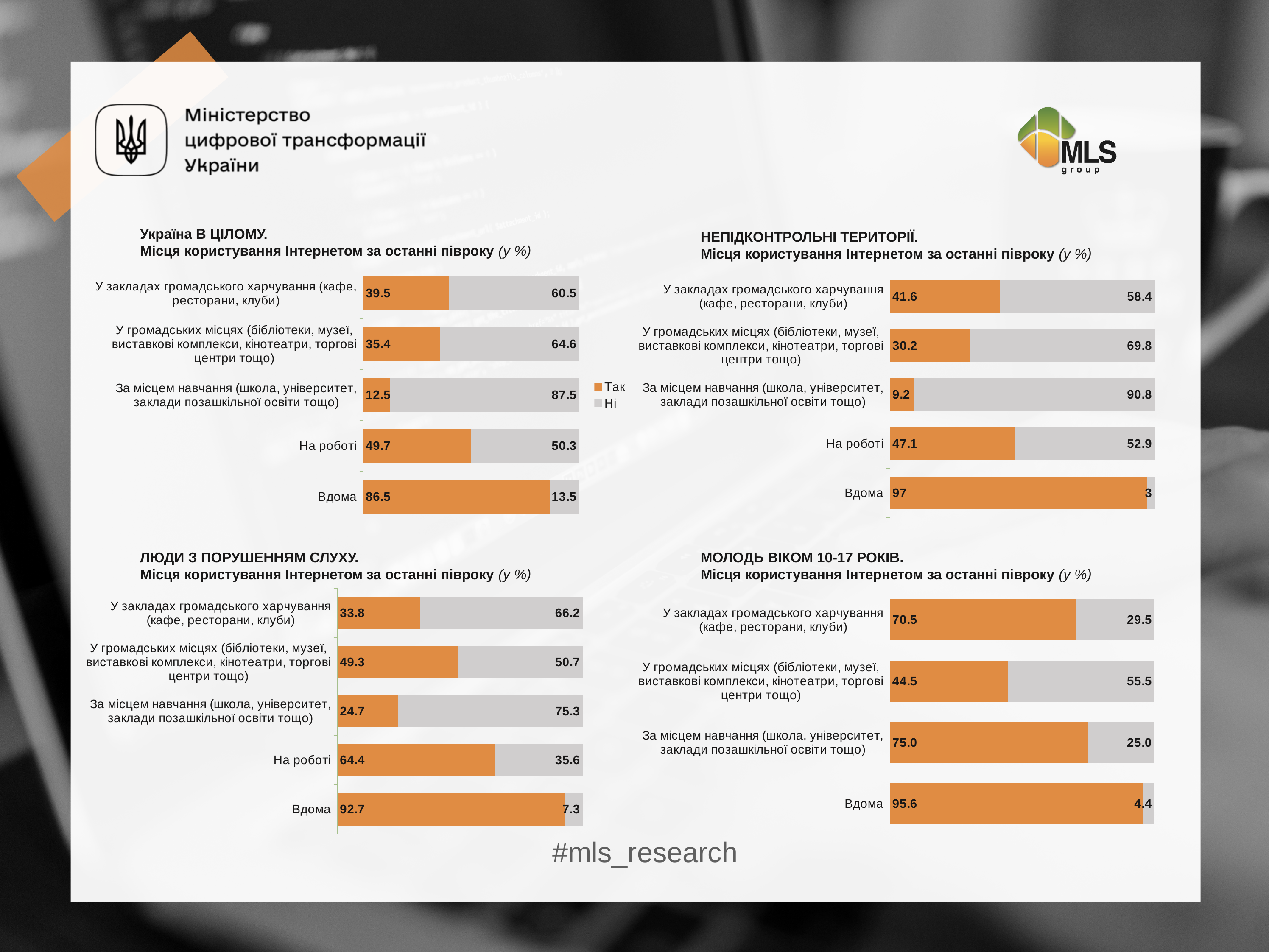
In the 'Україна В ЦІЛОМУ' chart, what is the 'Так' value for 'Вдома'? 86.5 What kind of chart is the 'НЕПІДКОНТРОЛЬНІ ТЕРИТОРІЇ' chart? Stacked bar chart In the 'ЛЮДИ З ПОРУШЕННЯМ СЛУХУ' chart, what is the 'Так' value for 'На роботі'? 64.4 In the 'НЕПІДКОНТРОЛЬНІ ТЕРИТОРІЇ' chart, what is the 'Ні' value for 'За місцем навчання (школа, університет, заклади позашкільної освіти тощо)'? 90.8 How many series does the legend list? 2 How many categories does the 'Україна В ЦІЛОМУ' chart show? 5 In the 'ЛЮДИ З ПОРУШЕННЯМ СЛУХУ' chart, which is larger: the 'Так' value for 'У закладах громадського харчування (кафе, ресторани, клуби)' or for 'У громадських місцях (бібліотеки, музеї, виставкові комплекси, кінотеатри, торгові центри тощо)'? У громадських місцях (бібліотеки, музеї, виставкові комплекси, кінотеатри, торгові центри тощо) In the 'НЕПІДКОНТРОЛЬНІ ТЕРИТОРІЇ' chart, what is the difference between the 'Так' values for 'Вдома' and 'На роботі'? 49.9 How many categories does the 'МОЛОДЬ ВІКОМ 10-17 РОКІВ' chart show? 4 In the 'МОЛОДЬ ВІКОМ 10-17 РОКІВ' chart, what is the total of the 'Вдома' bar? 100 In the 'Україна В ЦІЛОМУ' chart, which category has the lowest 'Так' value? За місцем навчання (школа, університет, заклади позашкільної освіти тощо) In the 'МОЛОДЬ ВІКОМ 10-17 РОКІВ' chart, which category has the highest 'Так' value? Вдома